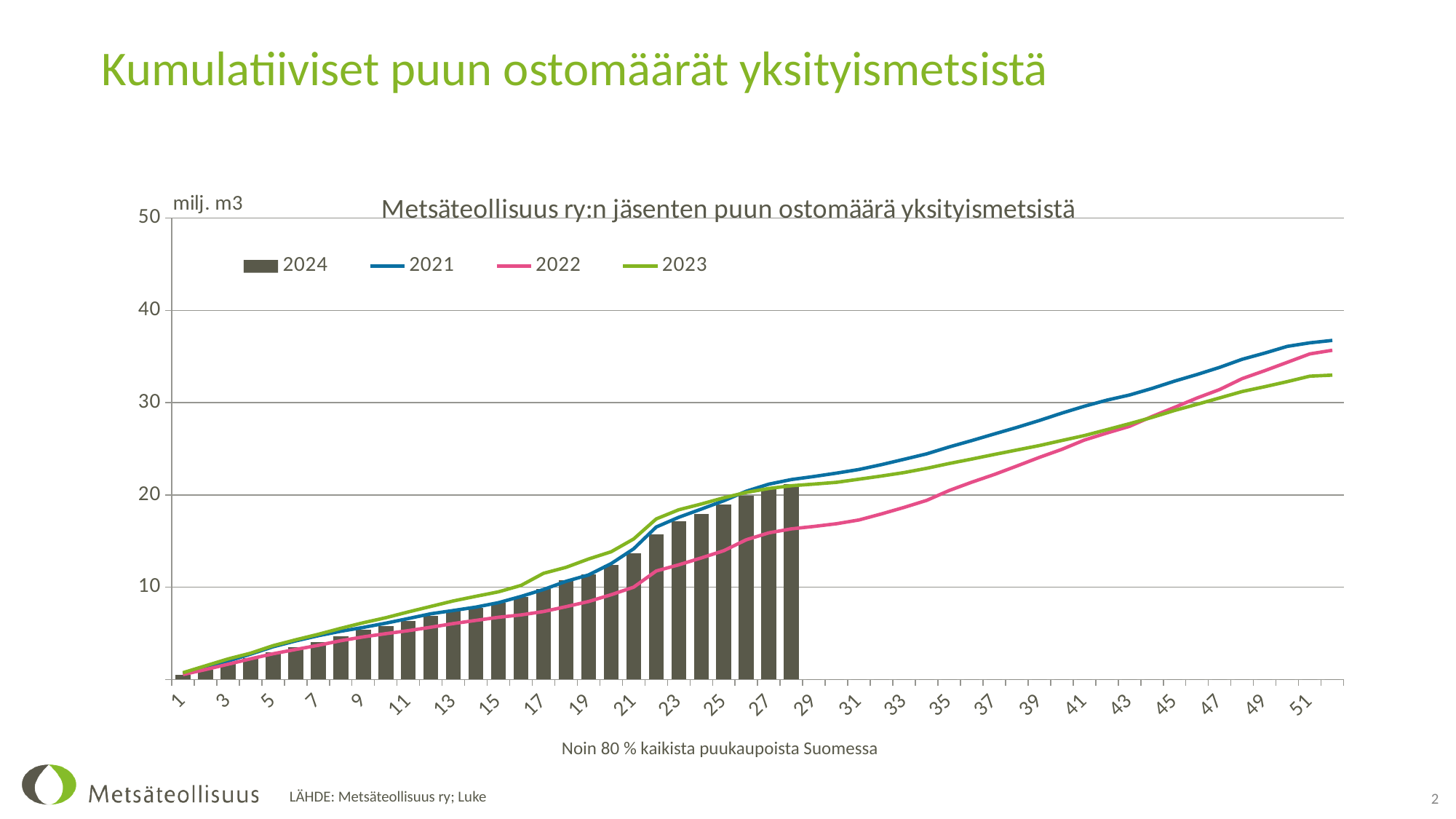
Is the 2022 value at week 51 greater or less than 30? greater At week 35, which is larger: the 2021 value or the 2022 value? 2021 Which series is drawn as bars rather than a line? 2024 Is the 2024 bar at week 21 greater or less than 20? less What is the title of the chart? Metsäteollisuus ry:n jäsenten puun ostomäärä yksityismetsistä Which series has the lowest value at week 35? 2022 How many series does the chart legend list? 4 Do the cumulative values rise or fall along the x axis for all series? Rise Which series has the highest value at week 51? 2021 Is the 2022 value at week 29 greater or less than 20? less What kind of chart is shown on the slide? A combination chart with bars (2024) and lines (2021, 2022, 2023) Which series has the lowest value at week 51? 2023